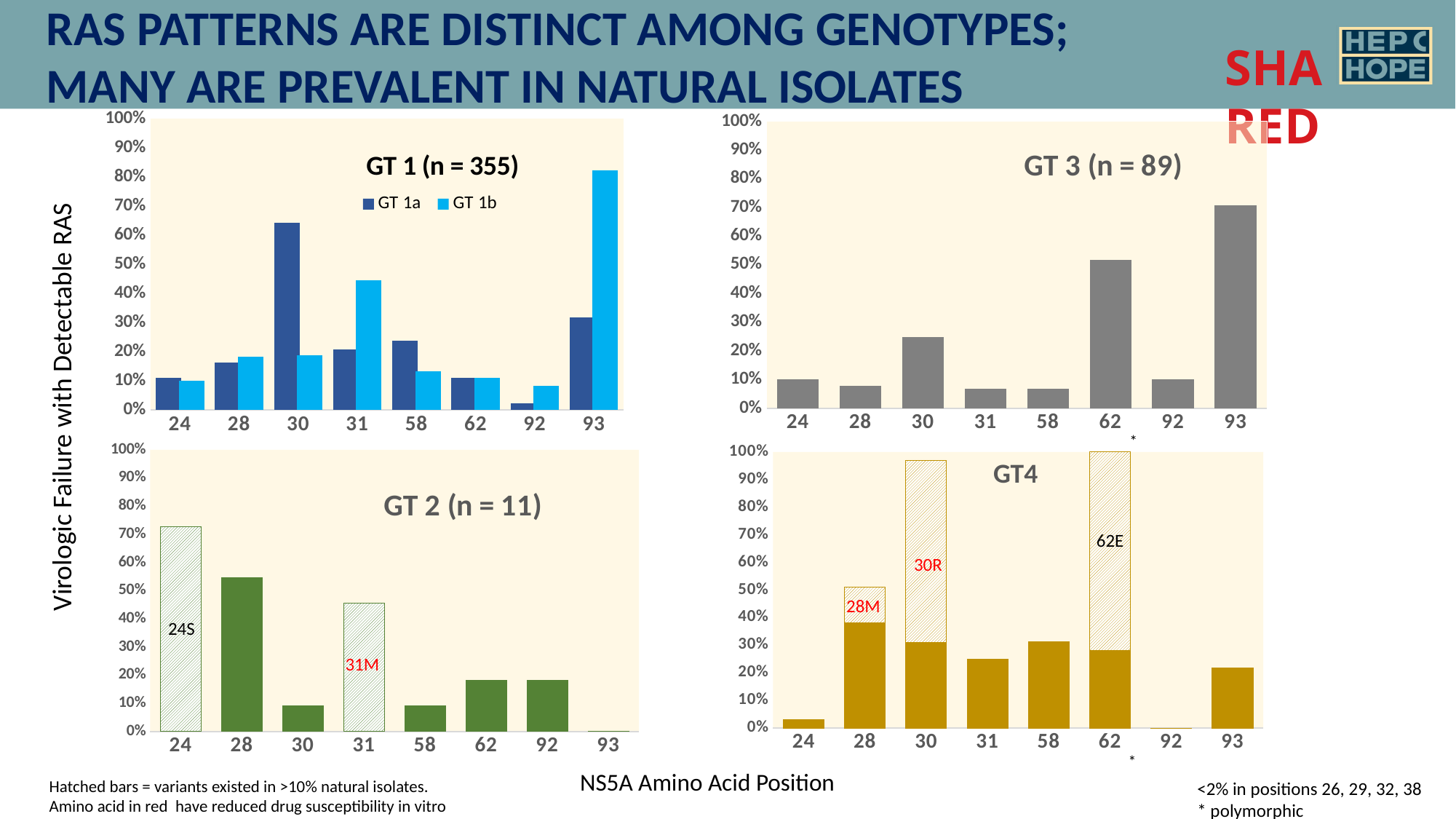
In the GT 1 (n = 355) chart, at which amino acid position is the GT 1a bar highest? 30 How many amino acid positions are shown on the x axis of the GT 2 (n = 11) chart? 8 In the GT 1 (n = 355) chart, which is larger at position 31: GT 1a or GT 1b? GT 1b In the GT4 chart, what label is printed on the hatched portion of the bar at position 62? 62E How many series does the legend of the GT 1 (n = 355) chart list? 2 In the GT 3 (n = 89) chart, is the value at position 93 greater or less than 60%? greater In the GT 3 (n = 89) chart, which amino acid position has the highest value? 93 In the GT4 chart, is the value at position 31 greater or less than 30%? less In the GT 2 (n = 11) chart, which amino acid position has the highest bar? 24 What kind of chart is the GT 1 (n = 355) chart? bar chart In the GT 1 (n = 355) chart, is the GT 1b value at position 93 greater or less than 70%? greater